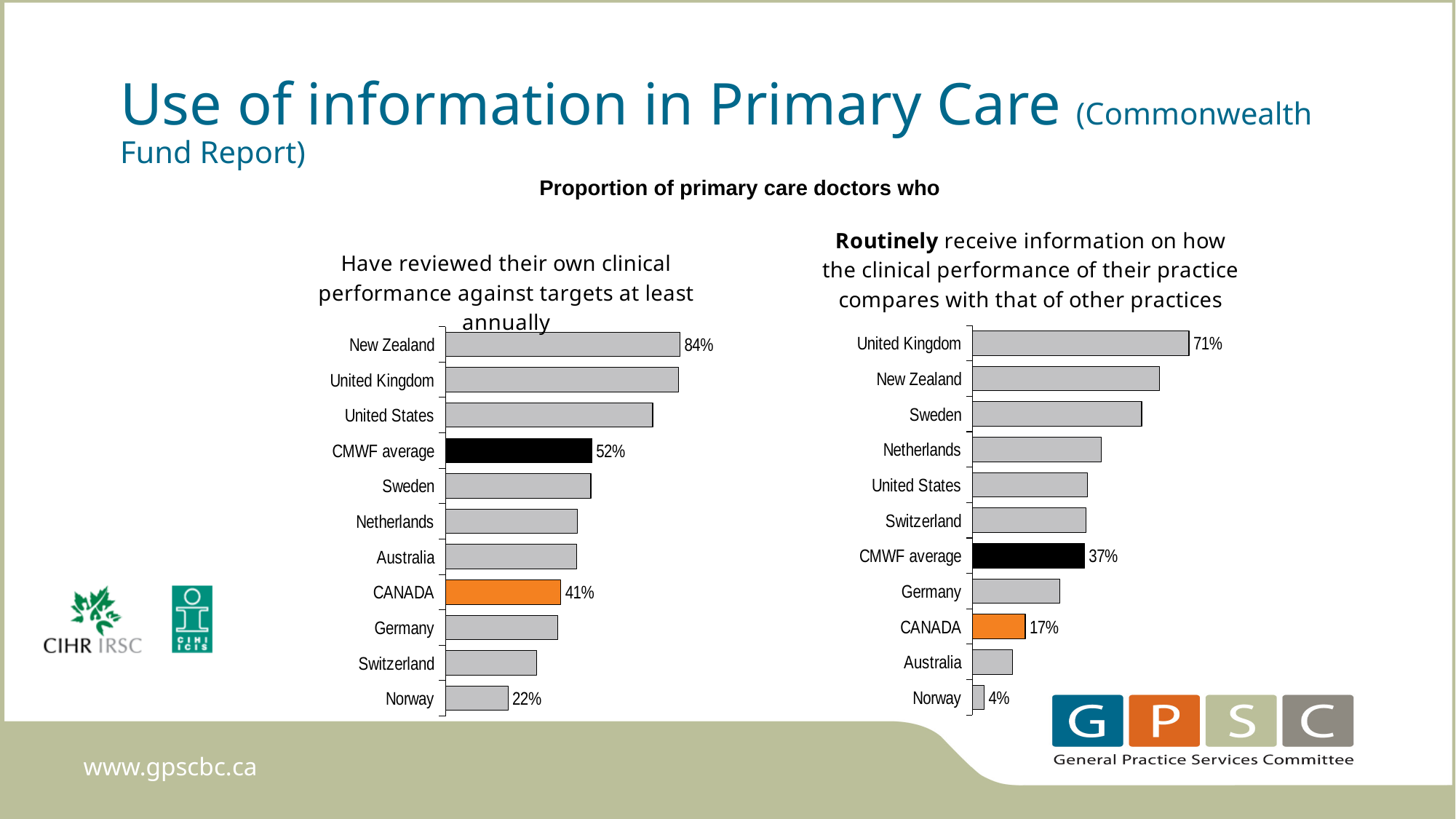
In the left chart (Have reviewed their own clinical performance against targets at least annually), which country has the lowest value? Norway In the right chart (Routinely receive information on how the clinical performance of their practice compares with that of other practices), which country has the highest value? United Kingdom In the left chart (Have reviewed their own clinical performance against targets at least annually), how many categories are plotted? 11 In the left chart (Have reviewed their own clinical performance against targets at least annually), which is larger, the value for United Kingdom or the value for Sweden? United Kingdom In the right chart (Routinely receive information on how the clinical performance of their practice compares with that of other practices), what is the value for CANADA? 17% In the left chart (Have reviewed their own clinical performance against targets at least annually), what is the value for CANADA? 41% In the left chart (Have reviewed their own clinical performance against targets at least annually), what is the difference between the CMWF average and CANADA? 11% In the left chart (Have reviewed their own clinical performance against targets at least annually), what is the value for New Zealand? 84% In the right chart (Routinely receive information on how the clinical performance of their practice compares with that of other practices), what is the difference between the CMWF average and CANADA? 20% What type of chart is the left chart (Have reviewed their own clinical performance against targets at least annually)? Bar chart In the right chart (Routinely receive information on how the clinical performance of their practice compares with that of other practices), what is the value for United Kingdom? 71% In the right chart (Routinely receive information on how the clinical performance of their practice compares with that of other practices), what is the value for Norway? 4%